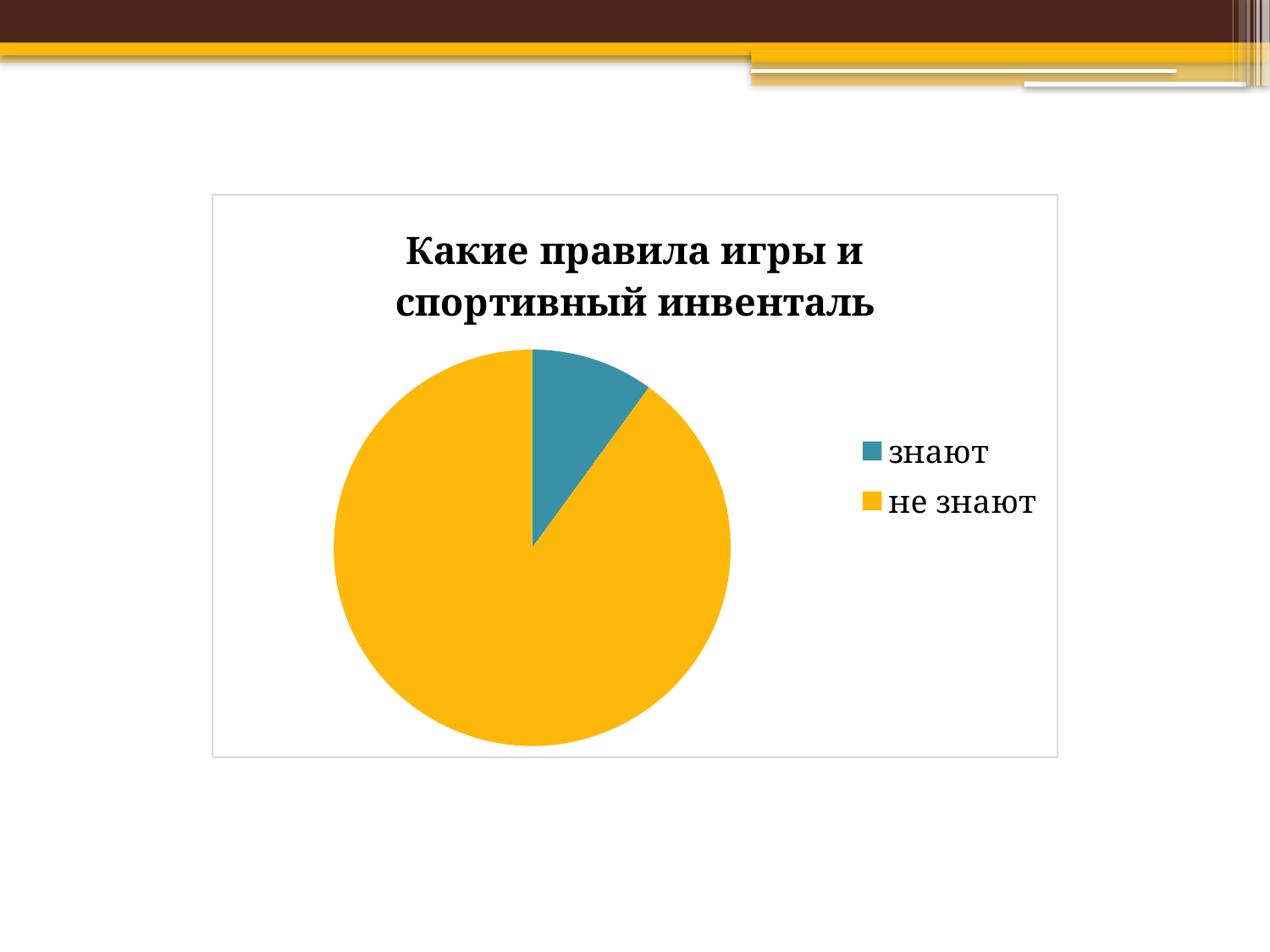
How many entries does the legend of the pie chart list? 2 Which category has the smallest slice of the pie chart? знают What kind of chart is shown on the slide? pie chart How many slices does the pie chart have? 2 Which slice is larger, "знают" or "не знают"? не знают What colour is the "не знают" slice in the pie chart? yellow What is the title of the pie chart? Какие правила игры и спортивный инвенталь Which category has the largest slice of the pie chart? не знают